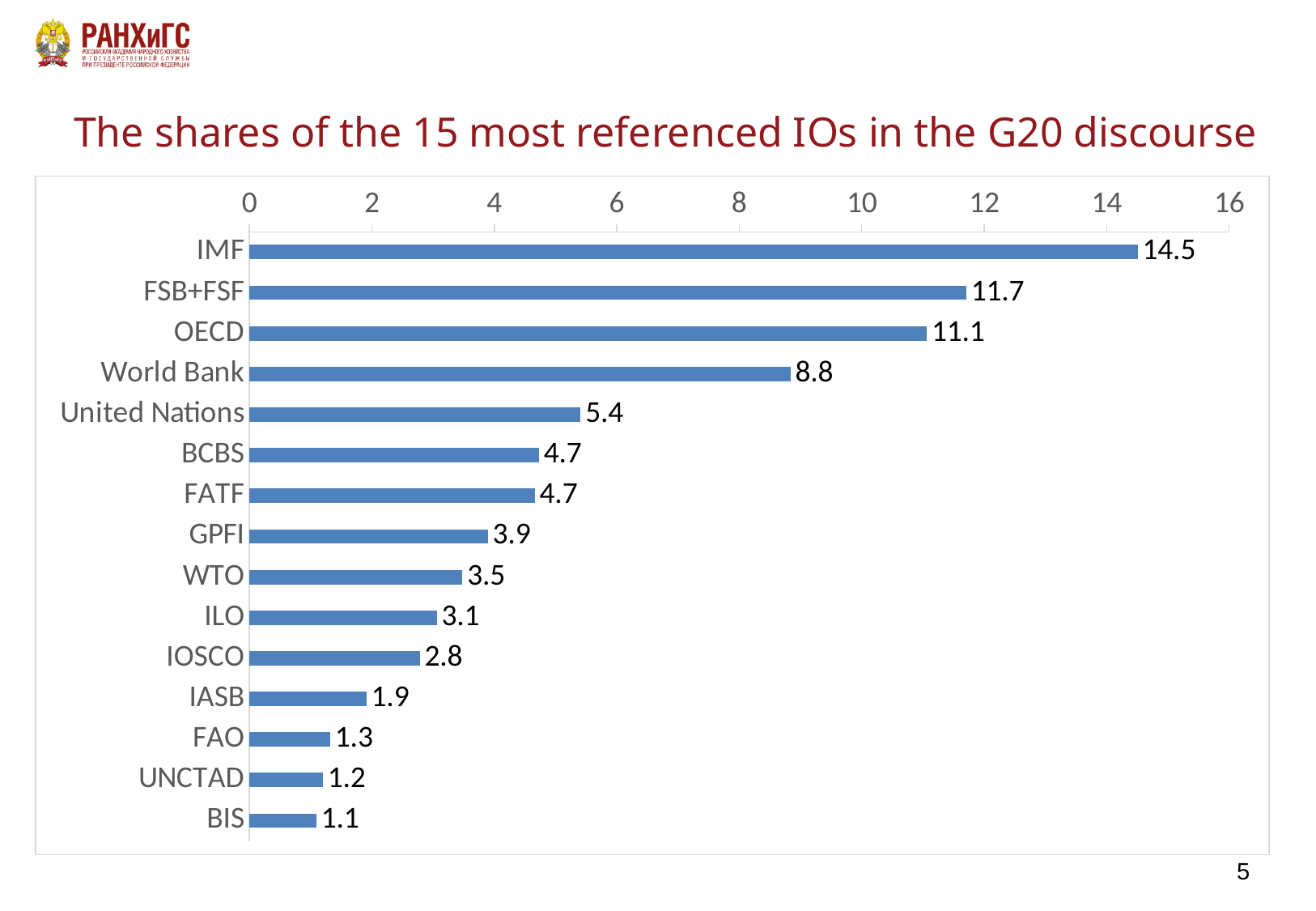
What is the title of the chart? The shares of the 15 most referenced IOs in the G20 discourse Which IO has the highest share? IMF Is the value for OECD greater or less than 10? greater Which IO has the lowest share? BIS Which is larger, the value for United Nations or the value for GPFI? United Nations What is the value for World Bank? 8.8 What is the value for WTO? 3.5 How many IOs are shown in the chart? 15 What is the value for IMF? 14.5 What kind of chart is shown on the slide? bar chart What is the difference between the values for OECD and World Bank? 2.3 What is the difference between the values for IMF and FSB+FSF? 2.8